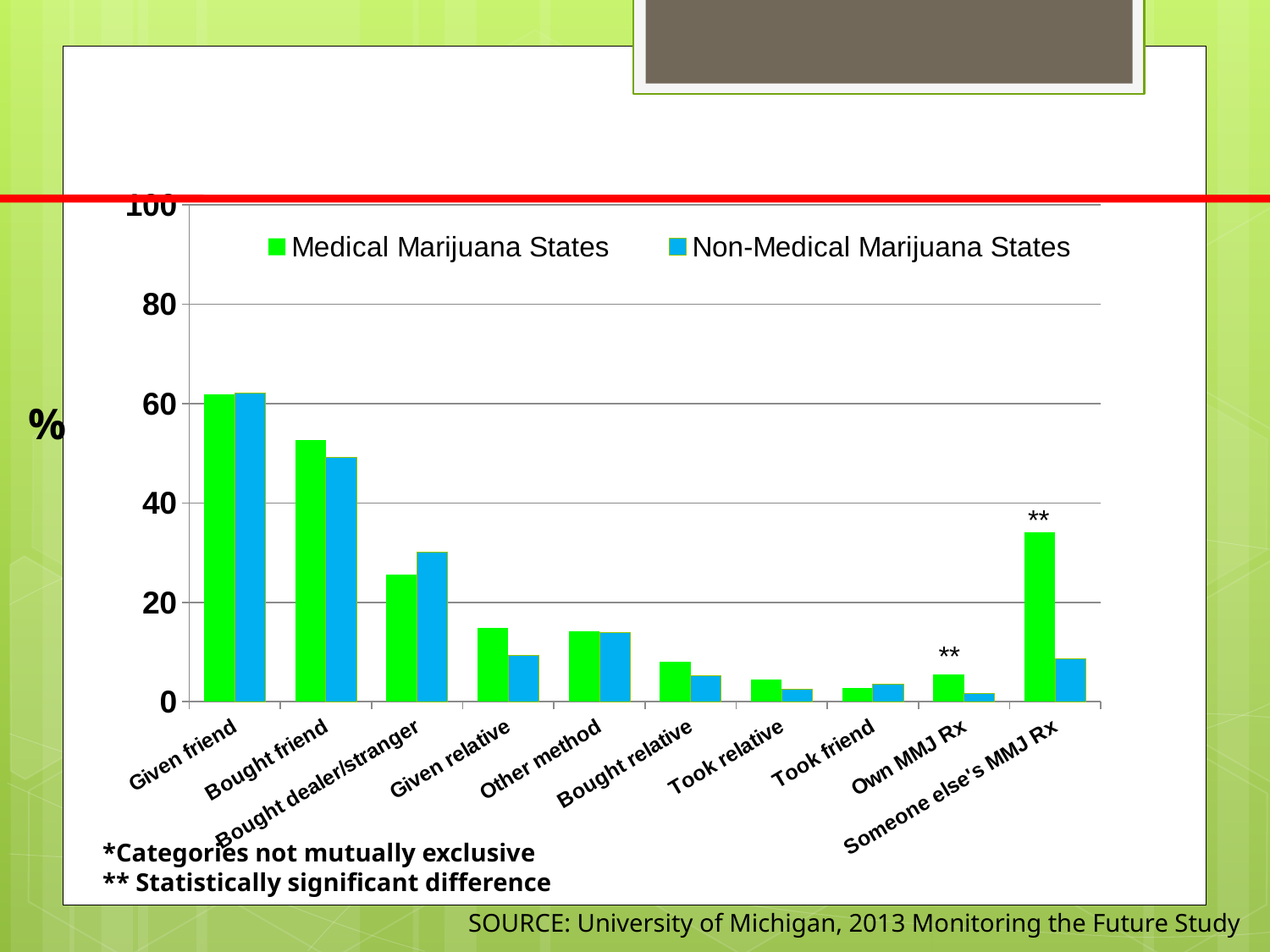
Is the value for Own MMJ Rx in Medical Marijuana States greater or less than 20? less What kind of chart is shown on the slide? bar chart Which category has the lowest value for Non-Medical Marijuana States? Own MMJ Rx How many series does the legend list? 2 Which category has the lowest value for Medical Marijuana States? Took friend Which category has the highest value for Medical Marijuana States? Given friend For Someone else's MMJ Rx, which series has the larger value, Medical Marijuana States or Non-Medical Marijuana States? Medical Marijuana States For Bought dealer/stranger, which series has the larger value, Medical Marijuana States or Non-Medical Marijuana States? Non-Medical Marijuana States Is the value for Someone else's MMJ Rx in Medical Marijuana States greater or less than 40? less Which two categories are marked with ** to indicate a statistically significant difference? Own MMJ Rx and Someone else's MMJ Rx Is the value for Bought friend in Medical Marijuana States greater or less than 40? greater How many categories are shown on the x axis? 10